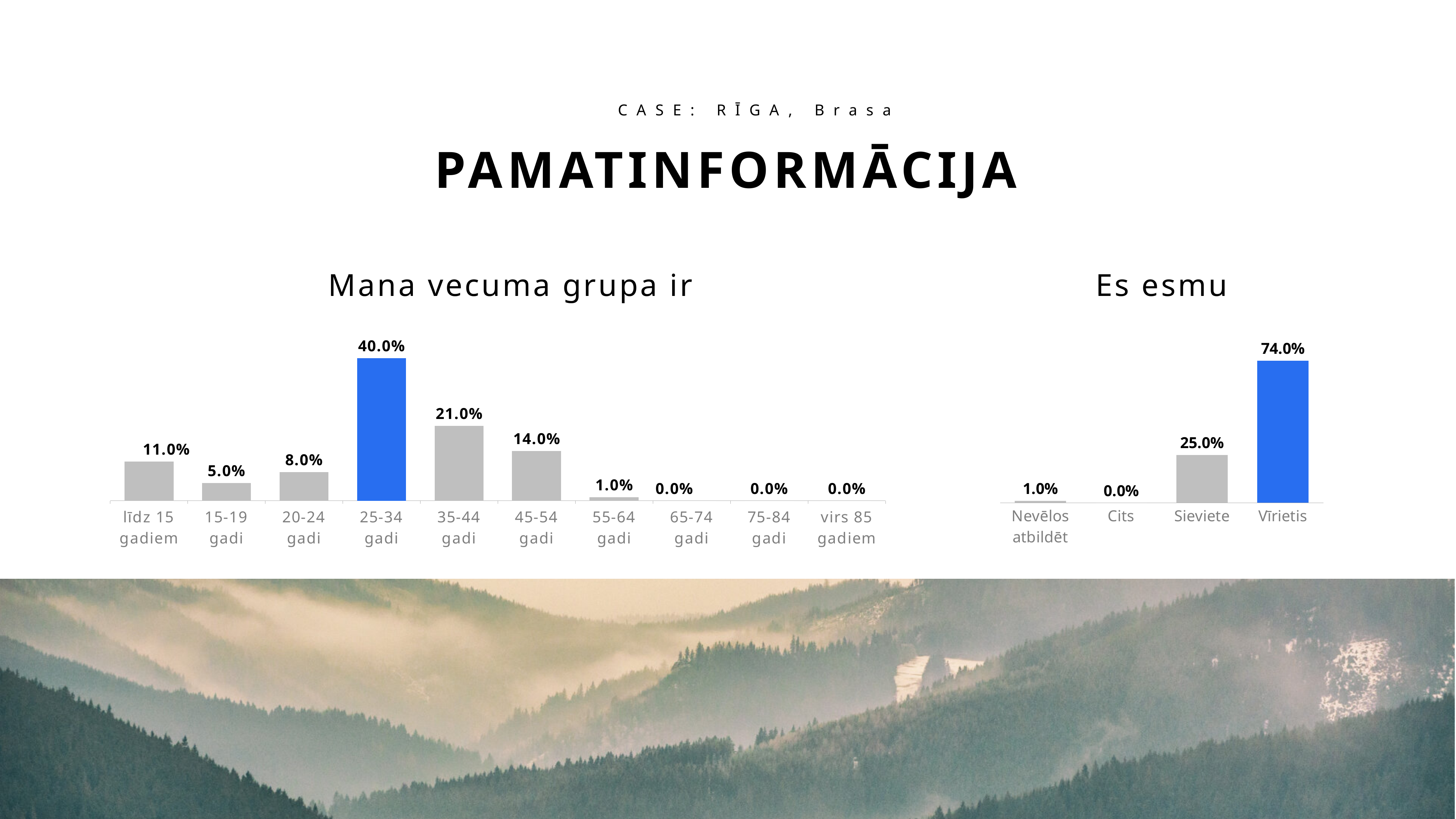
In the 'Es esmu' chart, how many categories are shown? 4 In the 'Mana vecuma grupa ir' chart, how many age group categories are shown? 10 In the 'Mana vecuma grupa ir' chart, which age group has the highest value? 25-34 gadi What kind of chart is the 'Es esmu' chart? Bar chart In the 'Es esmu' chart, what is the difference between the values for Vīrietis and Sieviete? 49.0% In the 'Es esmu' chart, what is the value for Vīrietis? 74.0% In the 'Mana vecuma grupa ir' chart, what is the value for 35-44 gadi? 21.0% In the 'Mana vecuma grupa ir' chart, what is the difference between the values for 25-34 gadi and 35-44 gadi? 19.0% In the 'Mana vecuma grupa ir' chart, what is the value for 45-54 gadi? 14.0% In the 'Mana vecuma grupa ir' chart, what is the value for 25-34 gadi? 40.0% In the 'Mana vecuma grupa ir' chart, which is larger, the value for līdz 15 gadiem or the value for 20-24 gadi? līdz 15 gadiem In the 'Es esmu' chart, what is the value for Sieviete? 25.0%